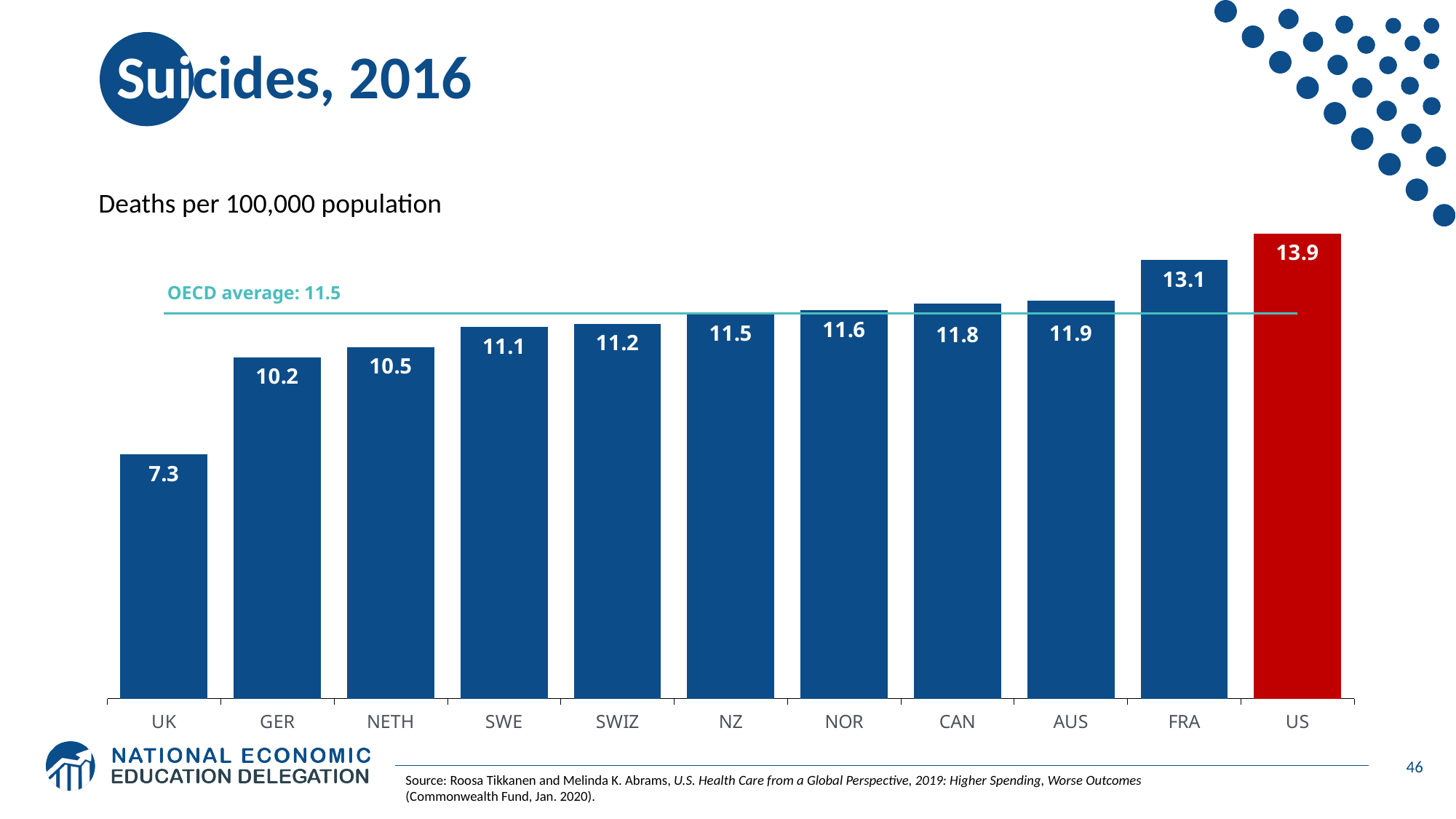
What is the value for GER? 10.2 Which country has the lowest value? UK What is the value for NOR? 11.6 Do the values rise or fall from left to right along the x axis? rise How many countries are shown in the chart? 11 What is the value for the US? 13.9 Which country has the highest value? US What is the difference between the values for the US and the UK? 6.6 What OECD average value is marked by the horizontal line on the chart? 11.5 What kind of chart is this? bar chart Which is larger, the value for SWE or the value for CAN? CAN What is the difference between the values for FRA and AUS? 1.2